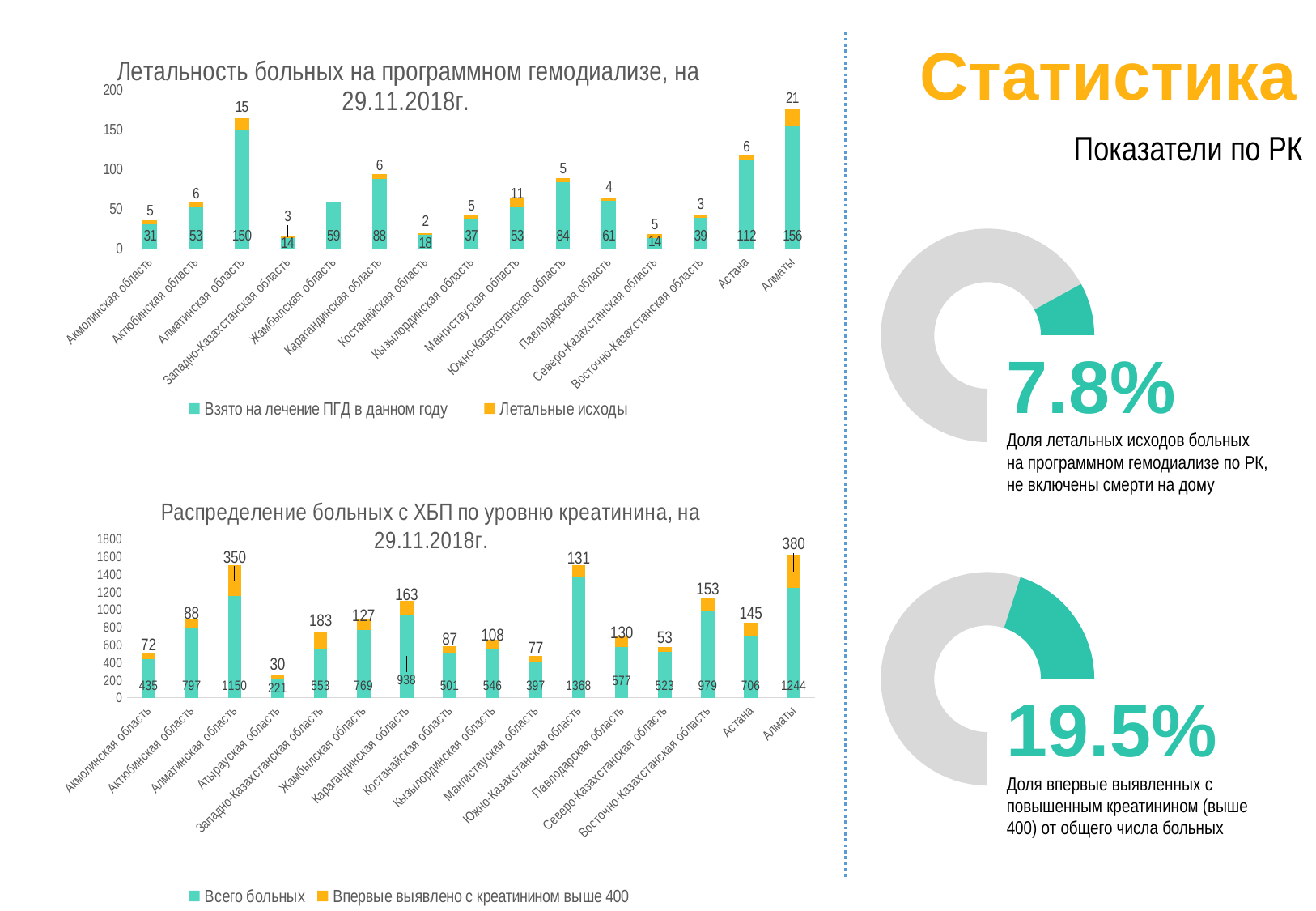
In the top chart 'Летальность больных на программном гемодиализе', how many 'Летальные исходы' are shown for Мангистауская область? 11 In the top chart 'Летальность больных на программном гемодиализе', which category has the highest number of 'Летальные исходы'? Алматы What type of chart is the bottom chart 'Распределение больных с ХБП по уровню креатинина'? Stacked bar chart In the bottom chart 'Распределение больных с ХБП по уровню креатинина', what is the total of the stacked bar for Астана? 851 How many series does the legend of the top chart 'Летальность больных на программном гемодиализе' list? 2 In the top chart 'Летальность больных на программном гемодиализе', what is the value of 'Взято на лечение ПГД в данном году' for Алматы? 156 In the bottom chart 'Распределение больных с ХБП по уровню креатинина', which is larger: 'Впервые выявлено с креатинином выше 400' for Алматинская область or for Алматы? Алматы In the bottom chart 'Распределение больных с ХБП по уровню креатинина', what is the value of 'Всего больных' for Южно-Казахстанская область? 1368 How many categories are shown on the x axis of the bottom chart 'Распределение больных с ХБП по уровню креатинина'? 16 In the top chart 'Летальность больных на программном гемодиализе', what is the difference between 'Взято на лечение ПГД в данном году' for Астана and for Карагандинская область? 24 In the bottom chart 'Распределение больных с ХБП по уровню креатинина', which category has the lowest value of 'Всего больных'? Атырауская область In the top chart 'Летальность больных на программном гемодиализе', what is the total height of the stacked bar for Алматинская область? 165